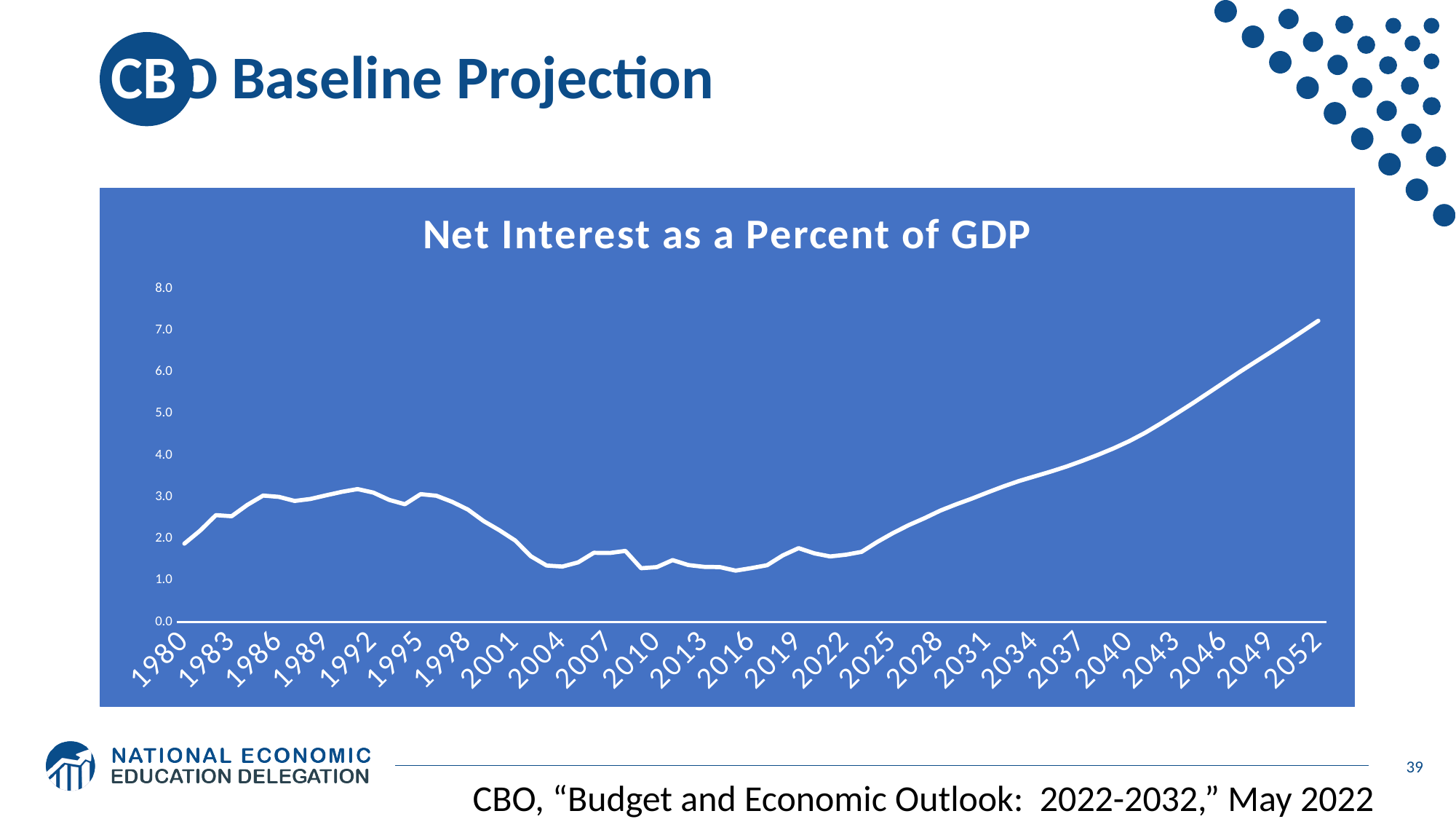
What is the title of the chart? Net Interest as a Percent of GDP In which year does the chart reach its highest value? 2052 Which year has the larger value, 1980 or 2052? 2052 Is the value for 2040 greater or less than 3.0? greater What kind of chart is shown on the slide? line chart Does the line rise or fall between 2022 and 2052? rise Is the value for 2052 greater or less than 6.0? greater Is the value for 1992 greater or less than 2.0? greater Which year has the larger value, 1992 or 2004? 1992 What is the highest value shown on the vertical axis? 8.0